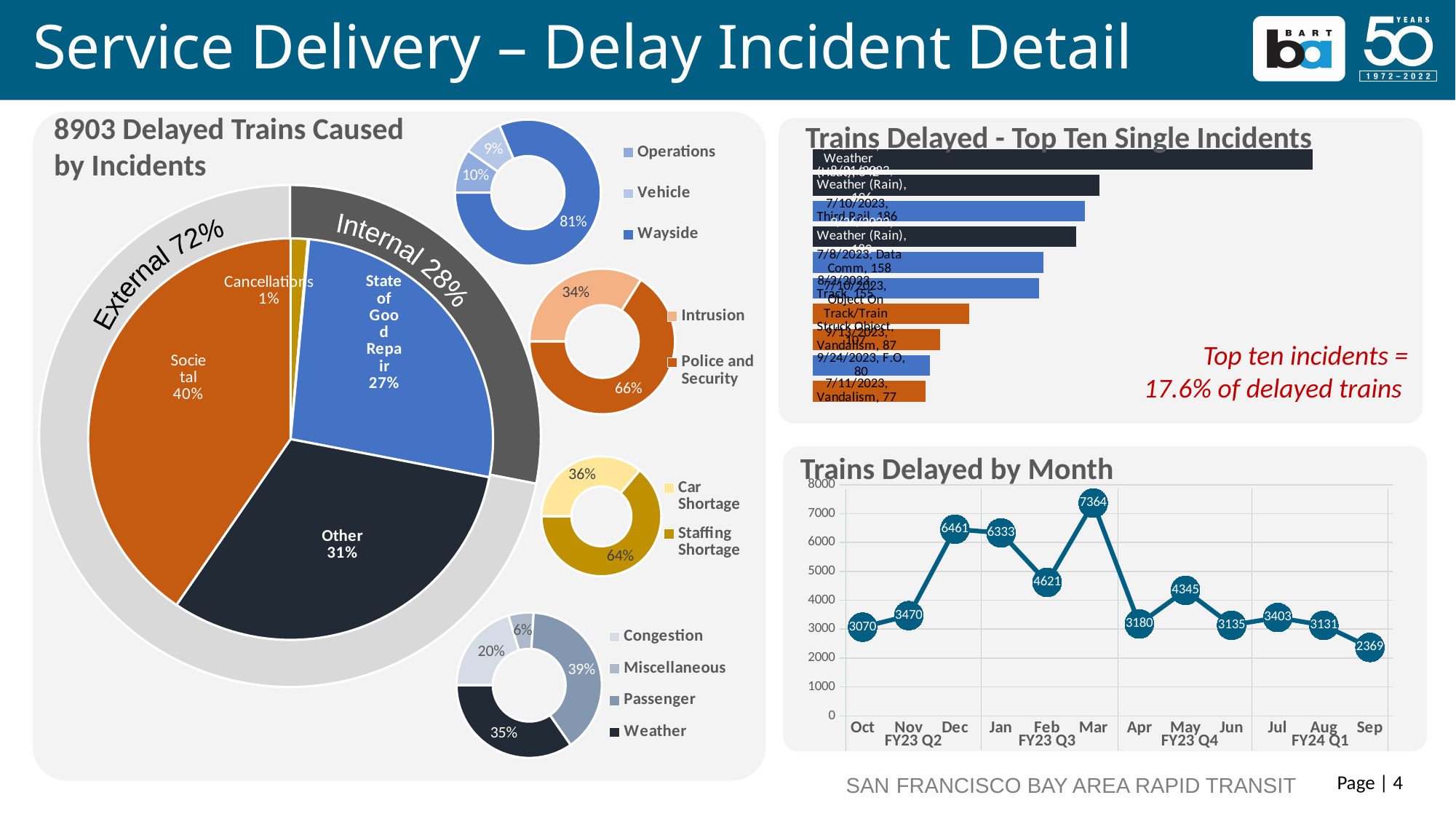
In the 'Trains Delayed by Month' chart, how many months are plotted? 12 In the '8903 Delayed Trains Caused by Incidents' pie chart, what share is Societal? 40% In the 'Trains Delayed by Month' chart, is the value for May greater or less than 4000? greater In the Intrusion / Police and Security donut chart, what share is Police and Security? 66% What type of chart is 'Trains Delayed by Month'? Line chart In the 'Trains Delayed by Month' chart, what is the difference between the December and November values? 2991 In the 'Trains Delayed by Month' chart, which month has the highest number of delayed trains? Mar What type of chart is 'Trains Delayed - Top Ten Single Incidents'? Bar chart In the '8903 Delayed Trains Caused by Incidents' pie chart, which slice is the smallest? Cancellations In the 'Trains Delayed by Month' chart, which month has the lowest number of delayed trains? Sep In the '8903 Delayed Trains Caused by Incidents' chart, what percentage of delays is External? 72% In the 'Trains Delayed by Month' chart, how many trains were delayed in March? 7364